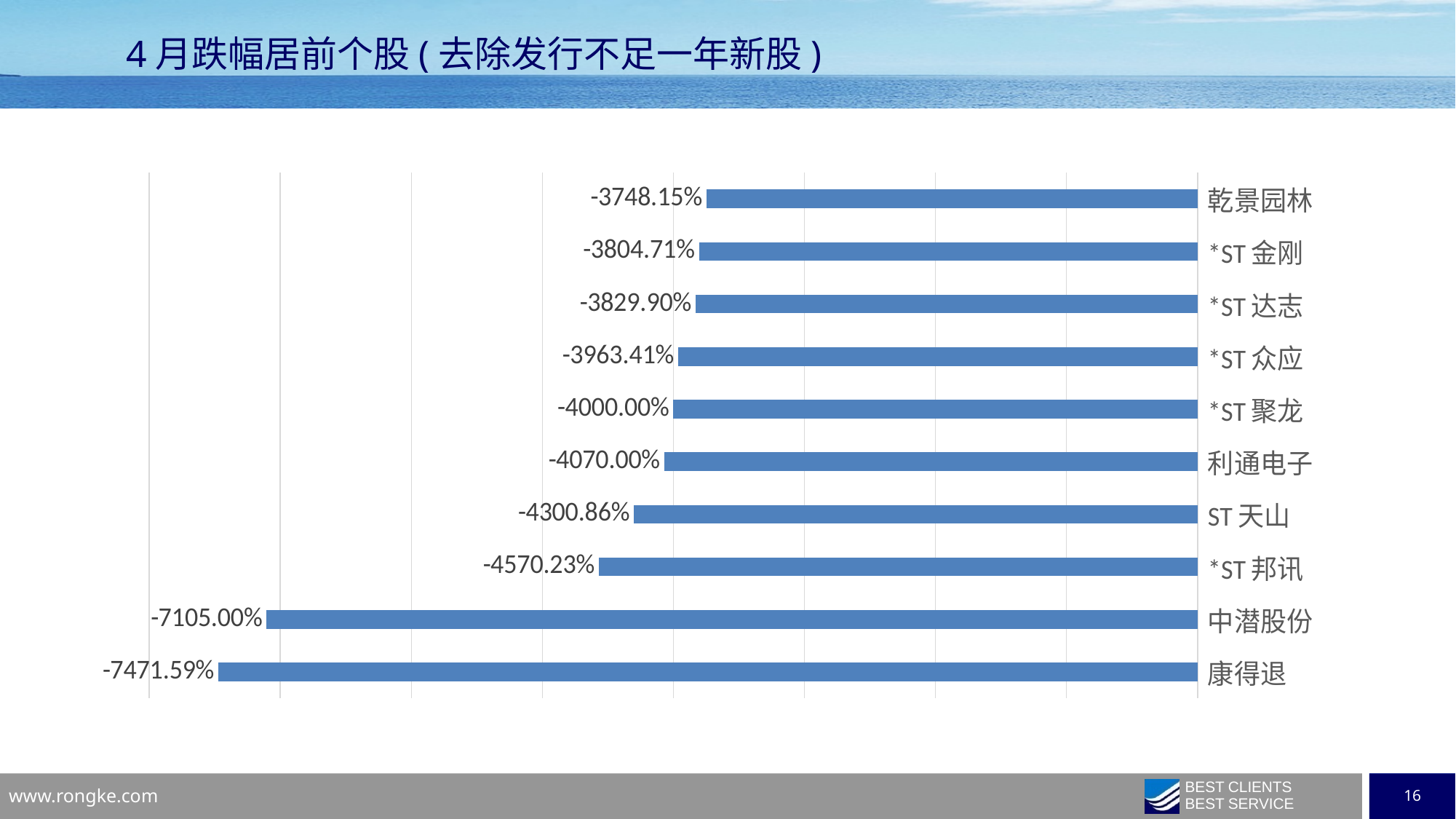
How many stocks are shown on the chart? 10 What is the title of the slide? 4 月跌幅居前个股 ( 去除发行不足一年新股 ) What is the difference between the values for 康得退 and 中潜股份? 366.59 percentage points Which stock has the lowest (most negative) value on the chart? 康得退 What is the value shown for 康得退? -7471.59% What is the difference between the values for *ST 邦讯 and ST 天山? 269.37 percentage points What is the value shown for 利通电子? -4070.00% Which stock has the highest (least negative) value on the chart? 乾景园林 What is the value shown for 中潜股份? -7105.00% What kind of chart is shown on the slide? Bar chart Which has the larger (less negative) value, *ST 众应 or *ST 邦讯? *ST 众应 What is the value shown for *ST 聚龙? -4000.00%